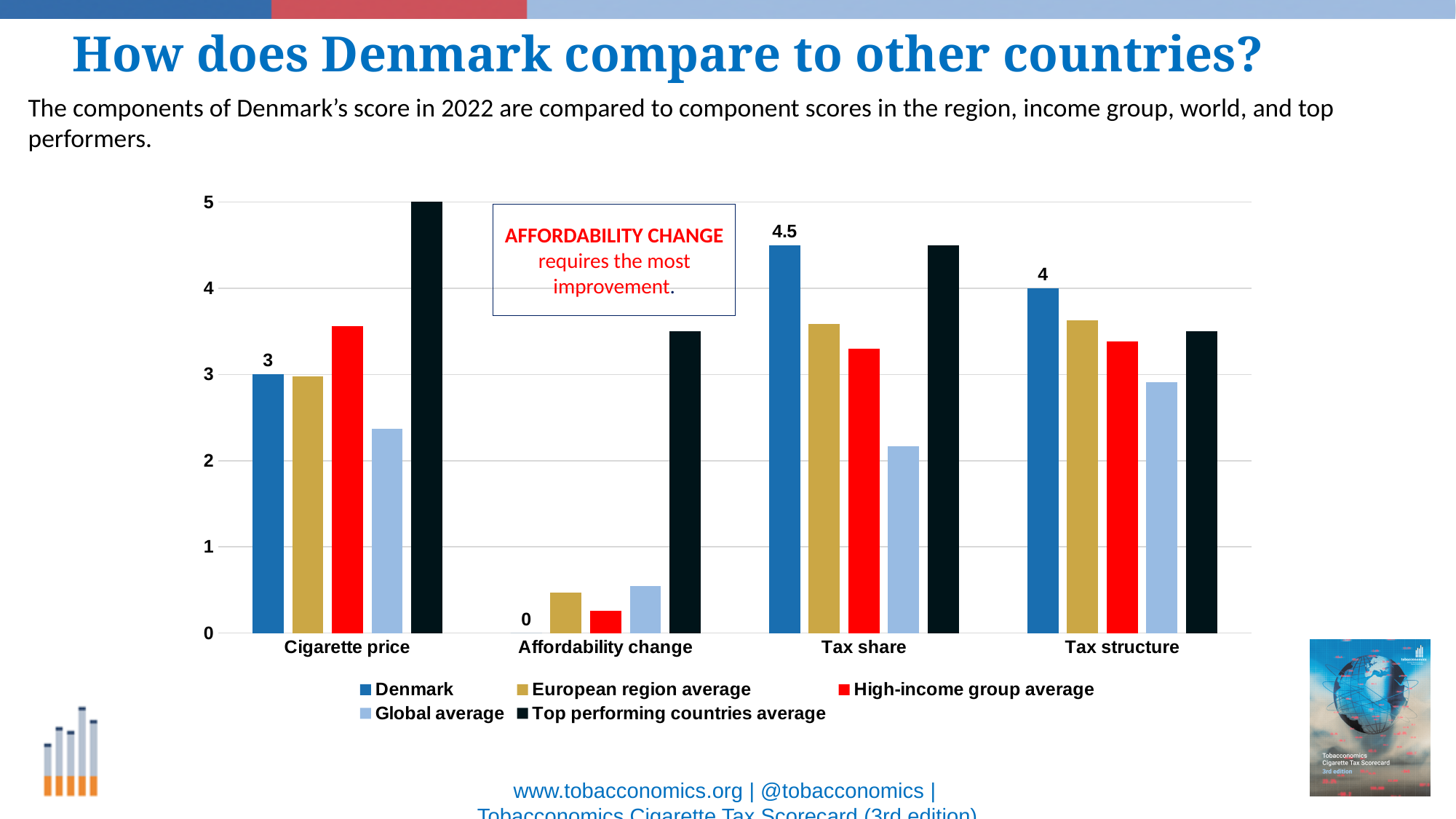
What is Denmark's score for Tax structure? 4 Is the Global average value for Cigarette price greater or less than 3? less What is Denmark's score for Cigarette price? 3 On which component does Denmark score lowest? Affordability change On which component does Denmark score highest? Tax share How many components (categories) are shown on the x axis? 4 How many series does the legend list? 5 What kind of chart is shown on the slide? Bar chart Is the Top performing countries average value for Affordability change greater or less than 3? greater What is Denmark's score for Affordability change? 0 What is Denmark's score for Tax share? 4.5 What is the difference between Denmark's Tax share score and its Tax structure score? 0.5